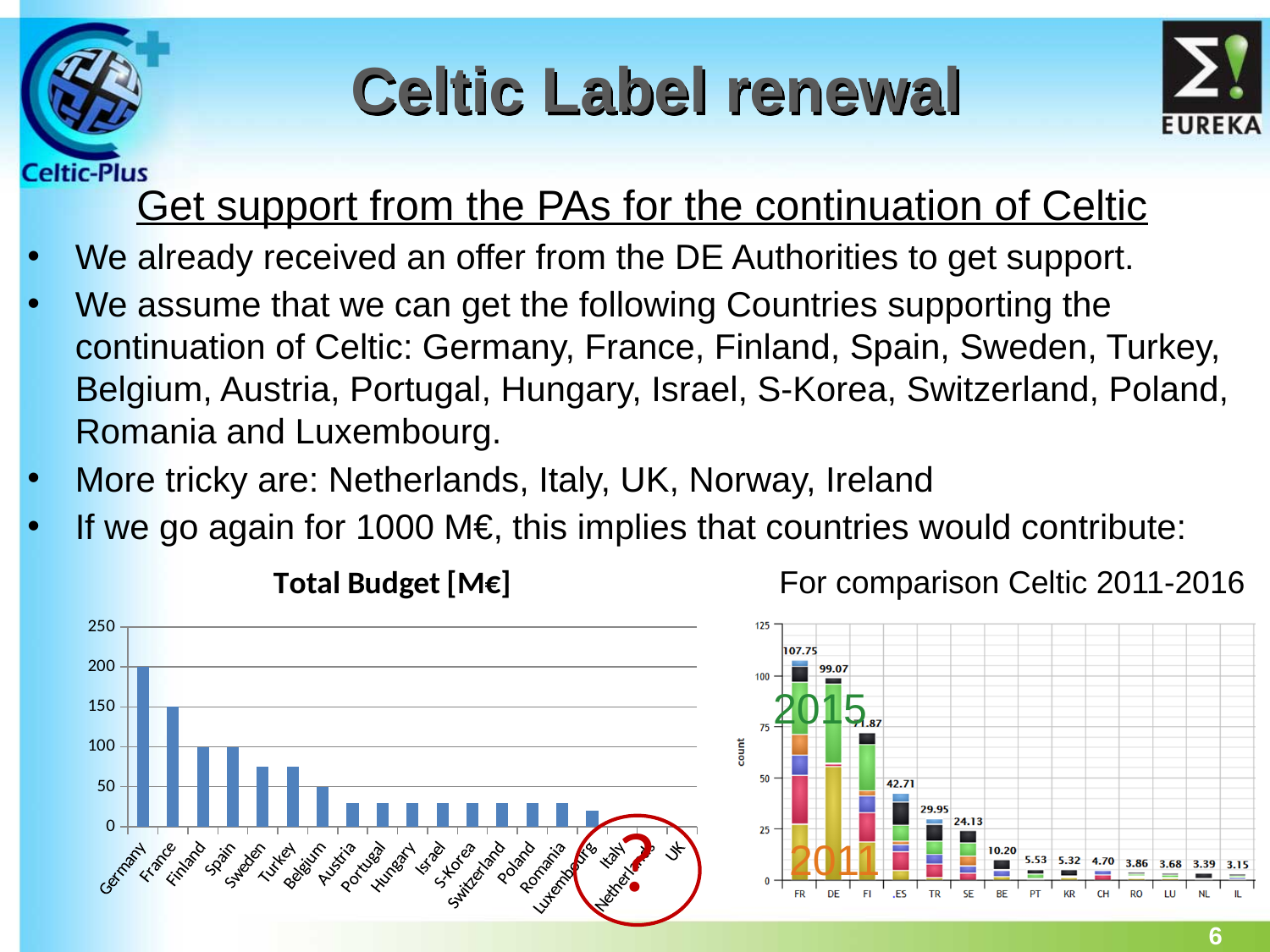
In the 'Total Budget [M€]' chart, what is the value for Germany? 200 In the 'For comparison Celtic 2011-2016' chart, what is the total for ES? 42.71 In the 'Total Budget [M€]' chart, is the value for Sweden greater or less than 50? greater In the 'Total Budget [M€]' chart, which is larger, the value for Finland or the value for Belgium? Finland How many countries are shown on the x axis of the 'For comparison Celtic 2011-2016' chart? 14 What kind of chart is the 'Total Budget [M€]' chart? bar chart In the 'For comparison Celtic 2011-2016' chart, what is the total for FR? 107.75 In the 'For comparison Celtic 2011-2016' chart, what is the difference between the totals for FR and DE? 8.68 In the 'Total Budget [M€]' chart, what is the value for France? 150 In the 'Total Budget [M€]' chart, which country has the highest value? Germany In the 'Total Budget [M€]' chart, is the value for Austria greater or less than 50? less In the 'For comparison Celtic 2011-2016' chart, which country has the lowest total? IL